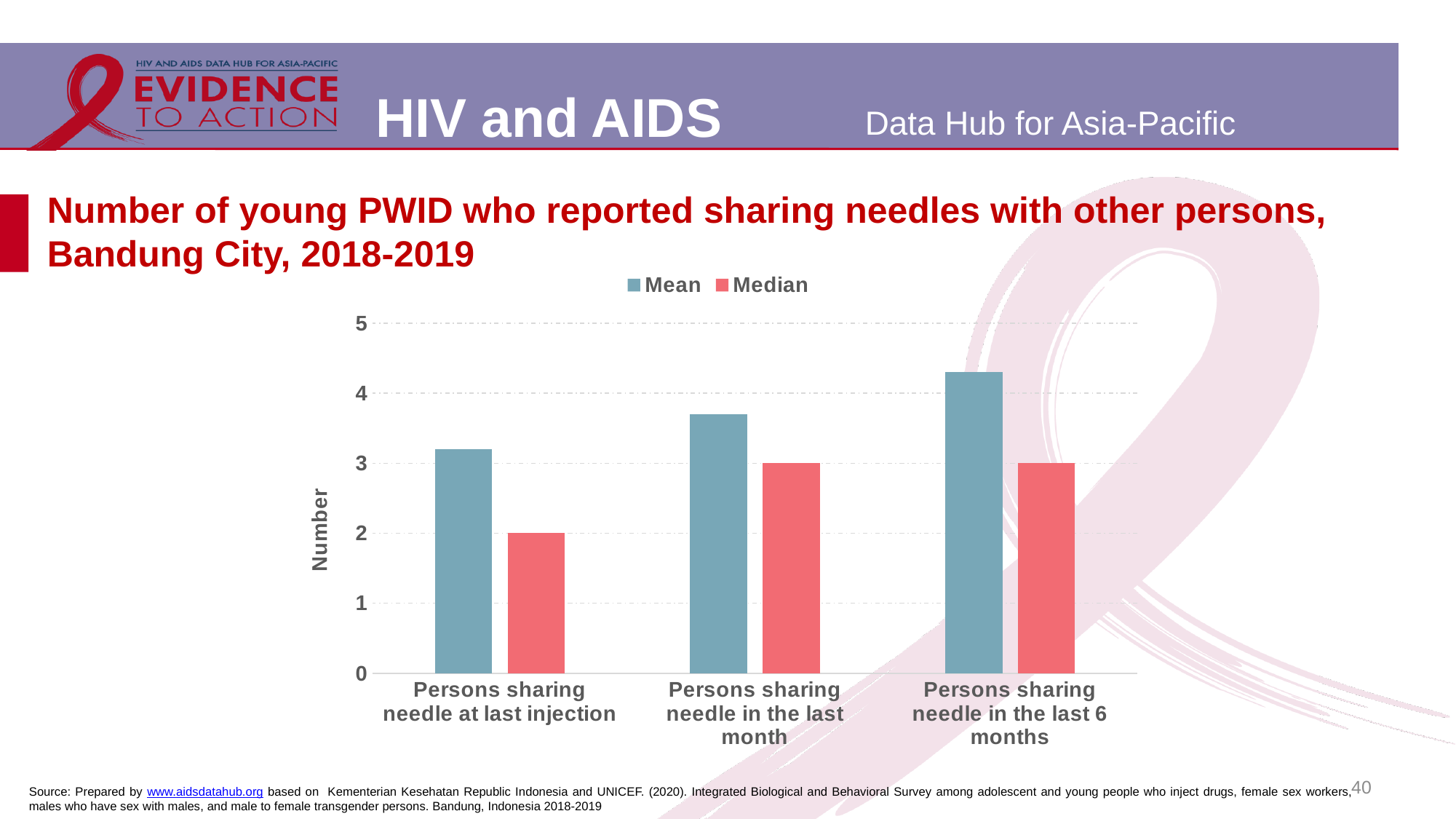
What is the Median value for persons sharing needle in the last 6 months? 3 Do the Mean values rise or fall from left to right across the categories? rise Is the Mean value for persons sharing needle at last injection greater or less than 3? greater Is the Mean value for persons sharing needle in the last 6 months greater or less than 4? greater What is the Median value for persons sharing needle at last injection? 2 Which category has the lowest Median value? Persons sharing needle at last injection Which category has the highest Mean value? Persons sharing needle in the last 6 months What is the Median value for persons sharing needle in the last month? 3 What type of chart is shown on the slide? bar chart How many series does the legend list? 2 Is the Mean value for persons sharing needle in the last month greater or less than 4? less How many categories are shown on the x axis? 3